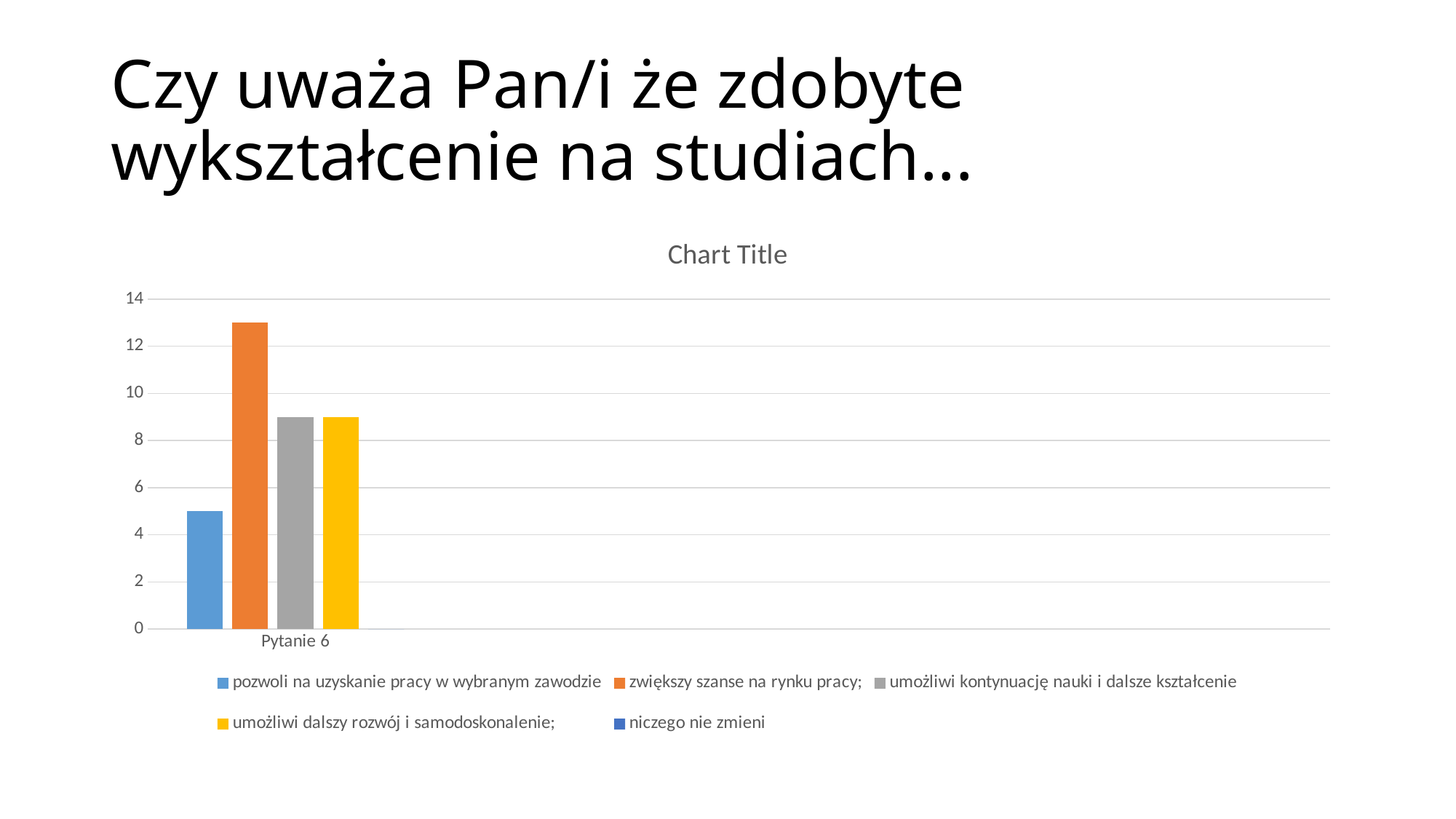
How many categories are shown on the x axis? 1 Which is larger: the bar for 'umożliwi kontynuację nauki i dalsze kształcenie' or the bar for 'pozwoli na uzyskanie pracy w wybranym zawodzie'? umożliwi kontynuację nauki i dalsze kształcenie Is the value for 'umożliwi dalszy rozwój i samodoskonalenie;' greater or less than 8? greater Is the value for 'zwiększy szanse na rynku pracy;' greater or less than 12? greater Is the value for 'umożliwi kontynuację nauki i dalsze kształcenie' greater or less than 10? less Which is larger: the bar for 'zwiększy szanse na rynku pracy;' or the bar for 'pozwoli na uzyskanie pracy w wybranym zawodzie'? zwiększy szanse na rynku pracy; What kind of chart is shown on the slide? bar chart What is the label of the category on the x axis? Pytanie 6 Which series has the highest bar? zwiększy szanse na rynku pracy; How many series does the legend list? 5 What colour is the bar for 'zwiększy szanse na rynku pracy;'? orange